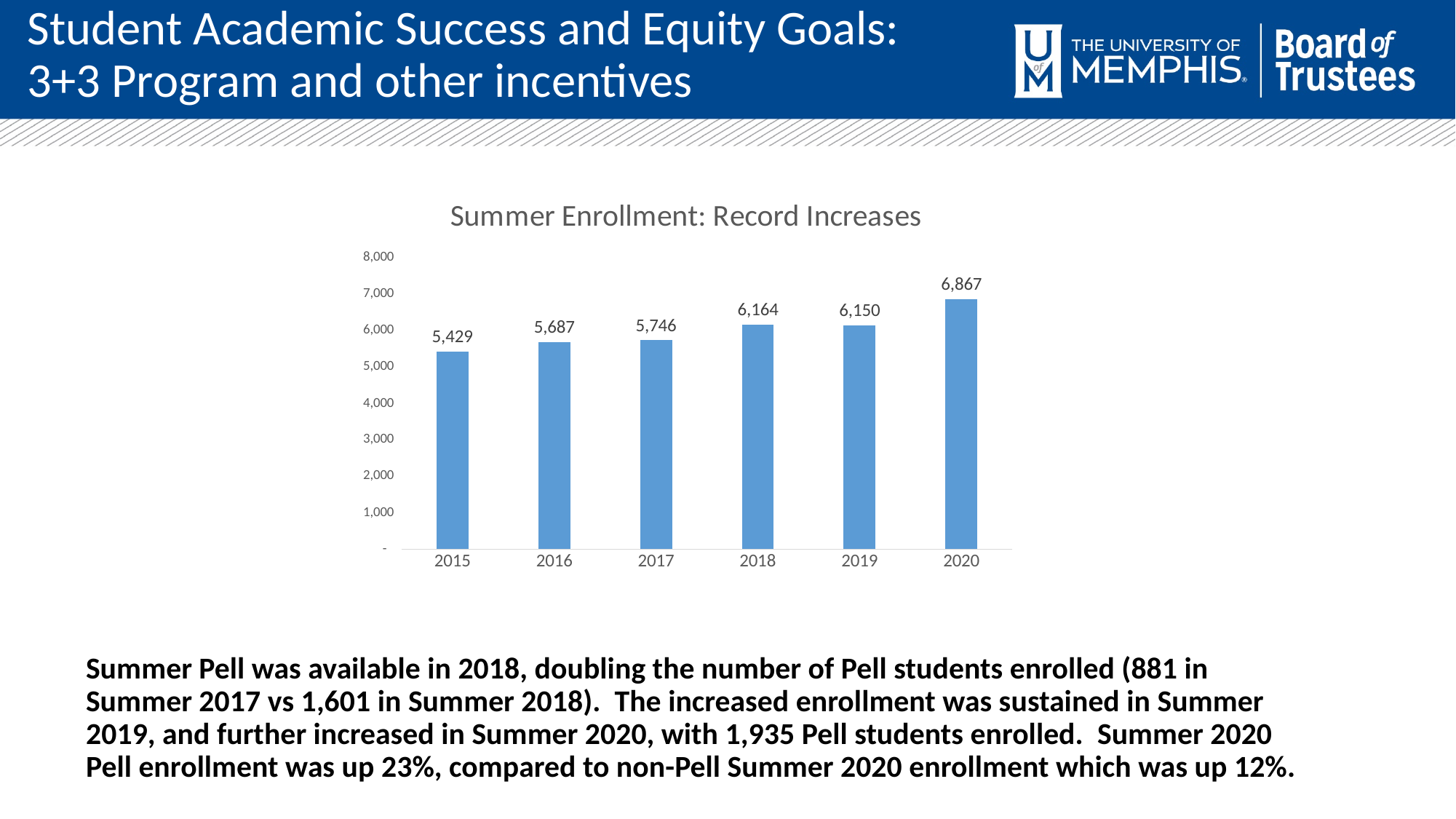
What is the summer enrollment value for 2020? 6,867 What is the summer enrollment value for 2015? 5,429 How many years are shown on the x axis of the chart? 6 Which year has the larger summer enrollment, 2017 or 2018? 2018 Which year has the lowest summer enrollment? 2015 What is the title of the chart? Summer Enrollment: Record Increases What kind of chart is shown on the slide? bar chart What is the difference in summer enrollment between 2016 and 2015? 258 What is the difference in summer enrollment between 2020 and 2019? 717 Is the summer enrollment value for 2019 greater or less than 6,000? greater What is the summer enrollment value for 2018? 6,164 Which year has the highest summer enrollment? 2020